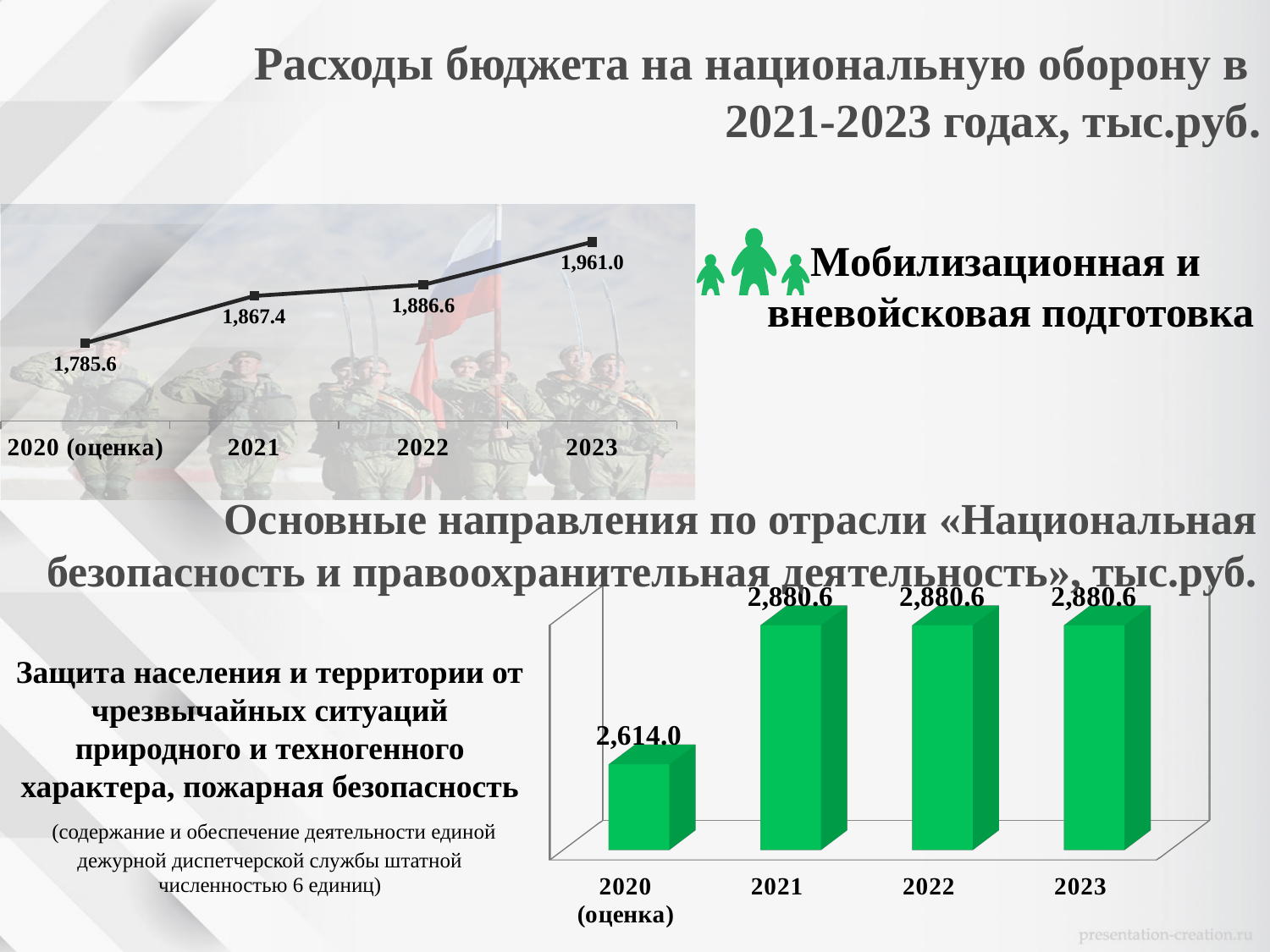
In the line chart at the top of the slide, how many data points are plotted? 4 In the line chart at the top of the slide, what is the difference between the 2023 value and the 2022 value? 74.4 What kind of chart is shown at the top of the slide? line chart In the line chart at the top of the slide, which year has the lowest value? 2020 (оценка) In the line chart at the top of the slide, what is the value for 2021? 1,867.4 In the bar chart at the bottom of the slide, what is the value for 2020 (оценка)? 2,614.0 In the line chart at the top of the slide, which year has the highest value? 2023 In the bar chart at the bottom of the slide, what is the value for 2022? 2,880.6 In the bar chart at the bottom of the slide, what is the difference between the 2021 value and the 2020 (оценка) value? 266.6 What kind of chart is shown at the bottom of the slide? bar chart In the line chart at the top of the slide, do the values rise or fall from 2020 (оценка) to 2023? rise In the line chart at the top of the slide, what is the value for 2020 (оценка)? 1,785.6